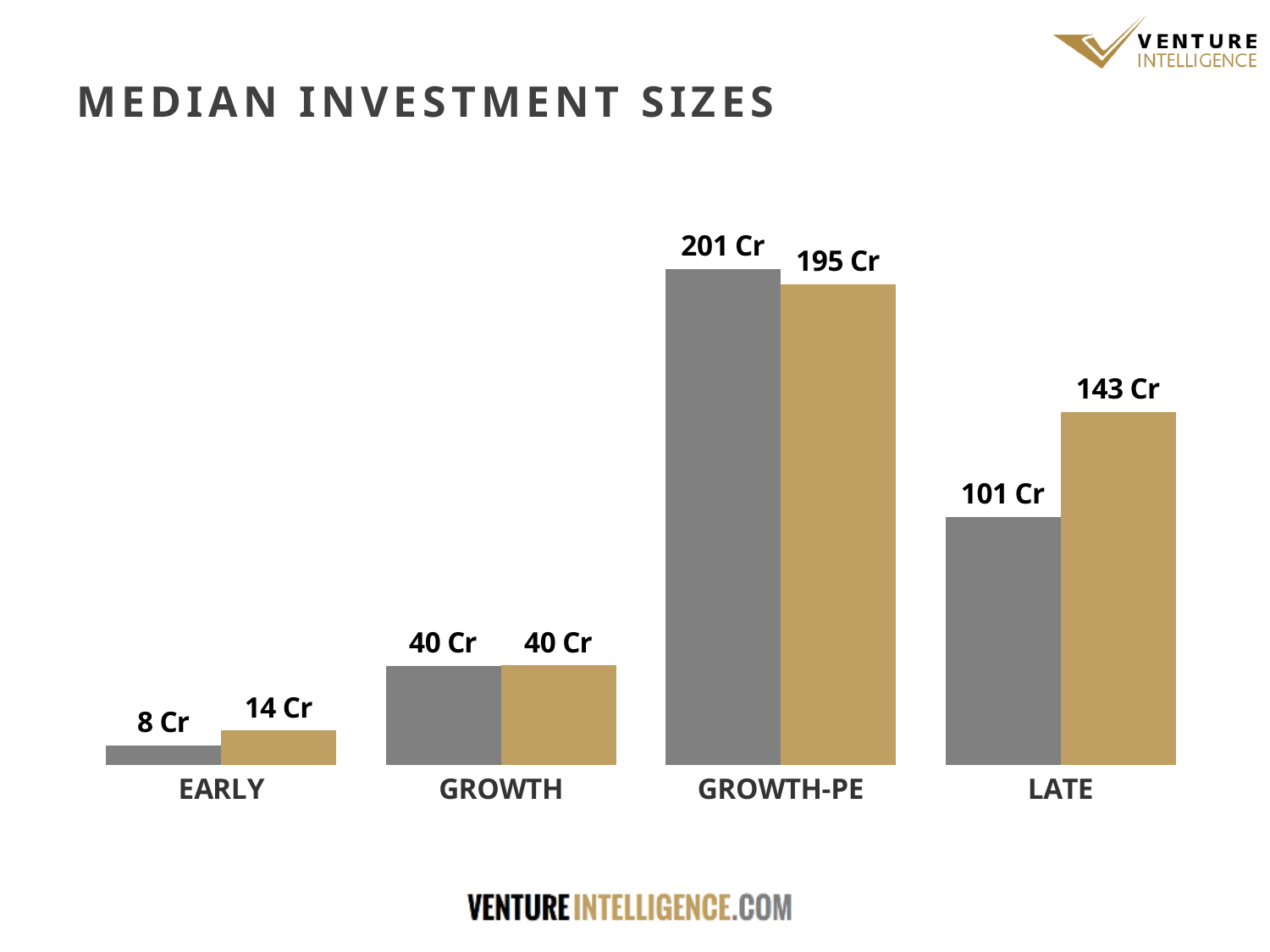
What is the value of the grey bar for GROWTH-PE? 201 Cr What is the difference between the grey and gold bars for GROWTH-PE? 6 Cr For EARLY, which bar is larger, the grey bar or the gold bar? the gold bar What is the title of the chart? MEDIAN INVESTMENT SIZES What kind of chart is shown on the slide? bar chart What is the value of the grey bar for EARLY? 8 Cr Which category has the lowest gold bar? EARLY What is the value of the gold bar for LATE? 143 Cr What is the difference between the grey and gold bars for LATE? 42 Cr How many categories are shown on the x axis? 4 What is the value of the gold bar for GROWTH? 40 Cr Which category has the highest grey bar? GROWTH-PE